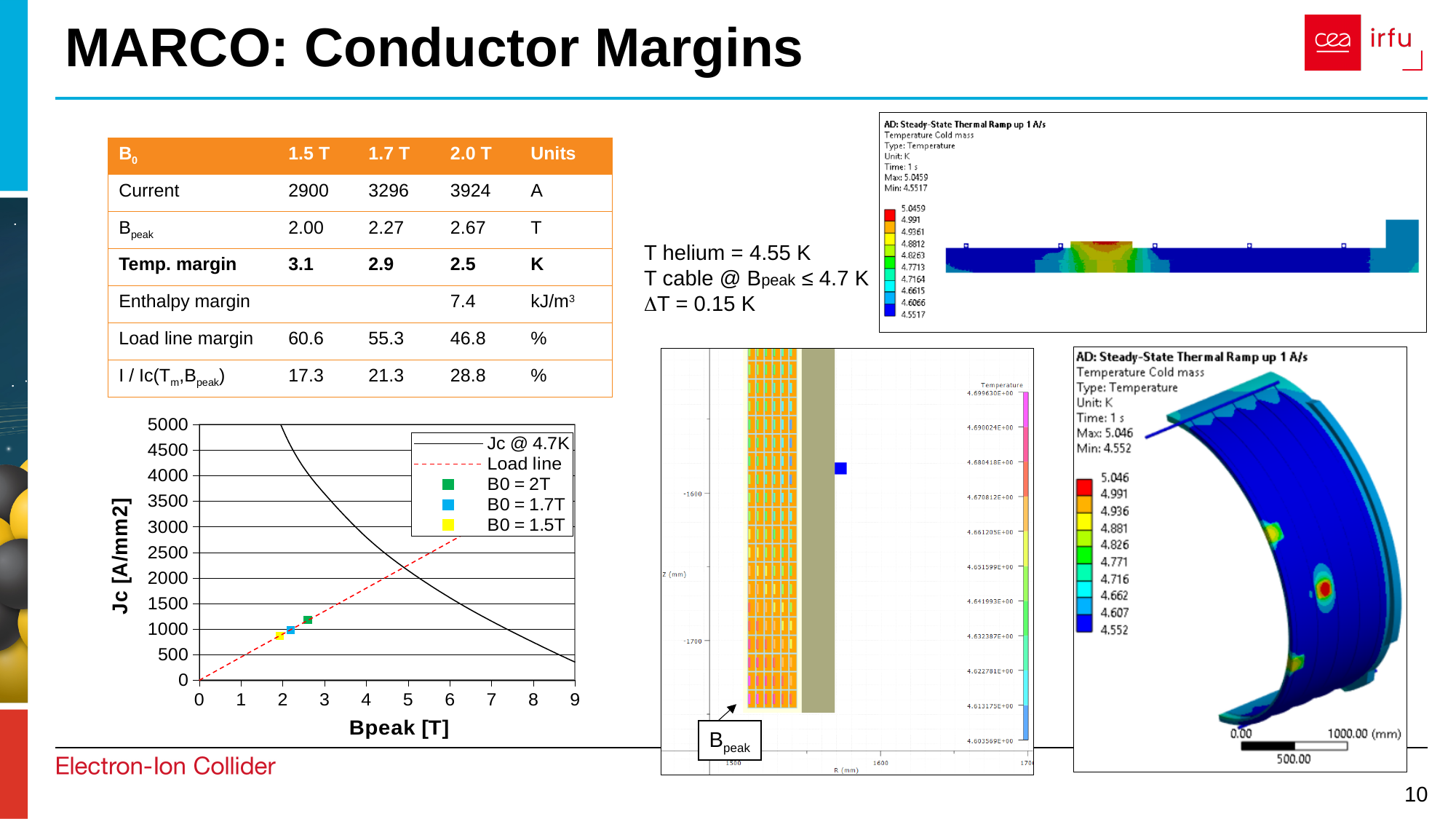
What kind of chart is the Jc versus Bpeak chart on the slide? line chart What is the label of the x axis of the Jc versus Bpeak chart? Bpeak [T] In the Jc versus Bpeak chart, does the Jc @ 4.7K curve rise or fall as Bpeak increases? fall What is the label of the y axis of the Jc versus Bpeak chart? Jc [A/mm2] In the Jc versus Bpeak chart, is the Jc value of the B0 = 2T point greater or less than 1000? greater In the Jc versus Bpeak chart, is the Jc value of the B0 = 1.5T point greater or less than 1000? less In the Jc versus Bpeak chart, is the Bpeak value of the B0 = 2T point greater or less than 2? greater In the Jc versus Bpeak chart, does the Load line rise or fall as Bpeak increases? rise In the Jc versus Bpeak chart, which of the three B0 points has the highest Jc value? B0 = 2T How many entries does the legend of the Jc versus Bpeak chart list? 5 In the Jc versus Bpeak chart, which of the three B0 points has the lowest Bpeak value? B0 = 1.5T